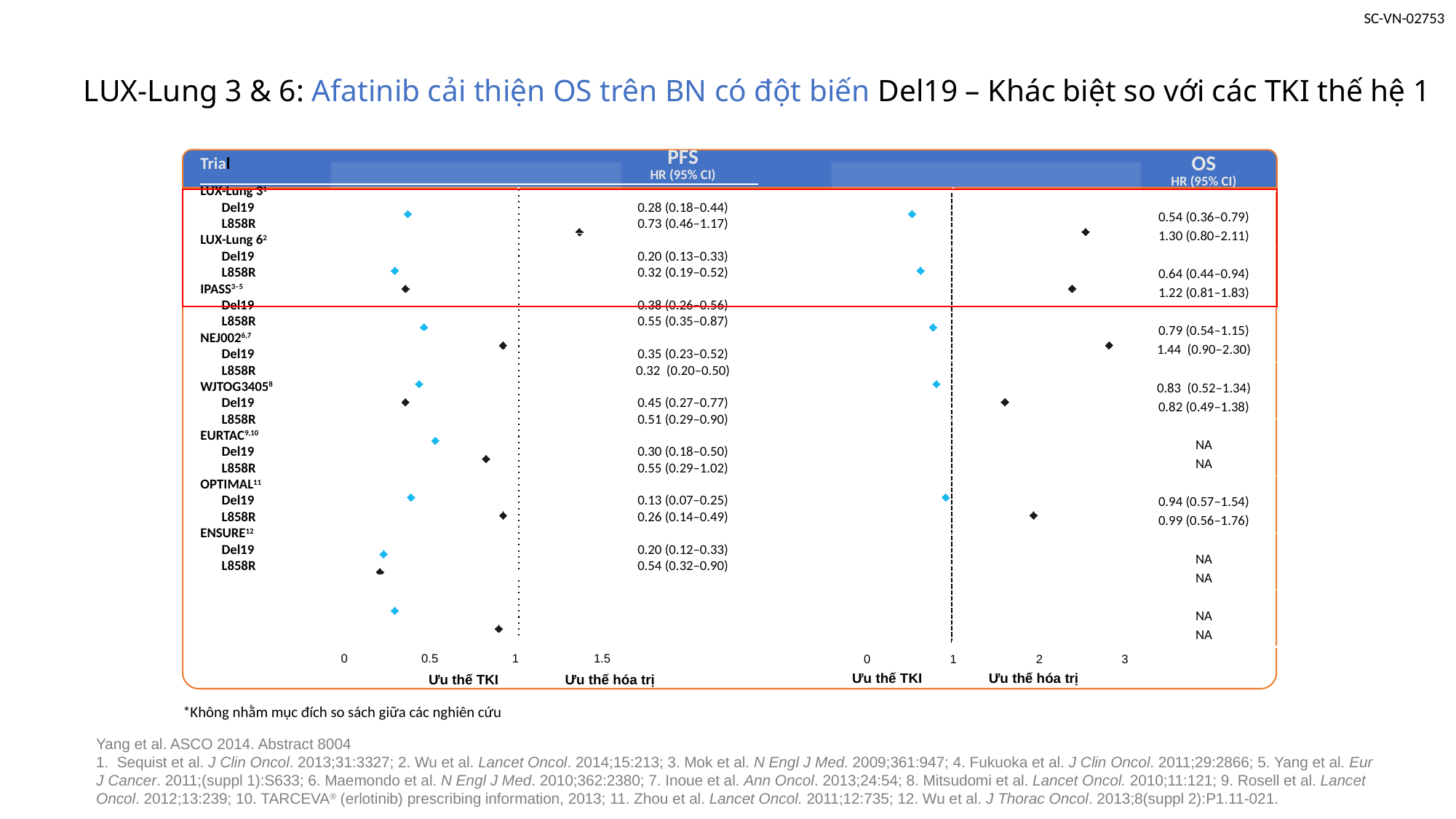
In the OS panel, what is the HR (95% CI) for Del19 in LUX-Lung 6? 0.64 (0.44–0.94) In the OS panel, what value is shown for Del19 and L858R in WJTOG3405? NA In the OS panel for LUX-Lung 3, what is the difference between the L858R and Del19 HR point estimates? 0.76 How many trials are listed in the chart? 8 In the OS panel, is the HR point estimate for L858R in LUX-Lung 6 greater or less than 1? greater In the PFS panel, what is the HR (95% CI) for Del19 in LUX-Lung 3? 0.28 (0.18–0.44) What kind of chart is shown on the slide? Forest plot In the PFS panel for LUX-Lung 6, which has the larger HR point estimate, Del19 or L858R? L858R In the PFS panel, what is the HR (95% CI) for Del19 in OPTIMAL? 0.13 (0.07–0.25) In the OS panel, which trial and mutation has the highest HR point estimate? IPASS L858R In the OS panel, what is the HR (95% CI) for L858R in LUX-Lung 3? 1.30 (0.80–2.11) In the PFS panel, which trial has the lowest HR point estimate for Del19? OPTIMAL